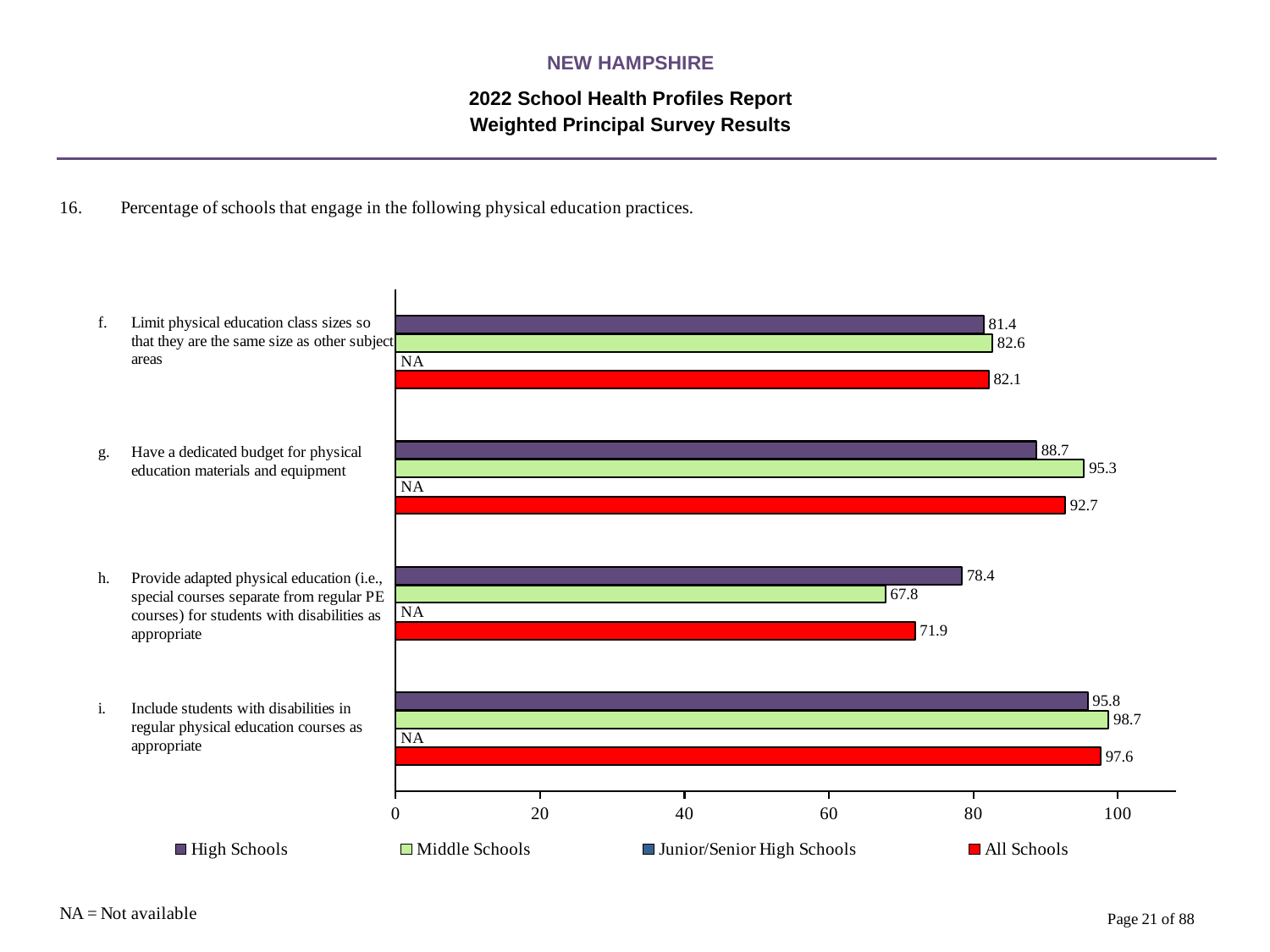
What is the High Schools value for practice g, having a dedicated budget for physical education materials and equipment? 88.7 How many series does the legend list? 4 What is the difference between the Middle Schools and High Schools values for practice g, having a dedicated budget for physical education materials and equipment? 6.6 Which practice has the highest Middle Schools value? i. Include students with disabilities in regular physical education courses as appropriate What is the Middle Schools value for practice h, providing adapted physical education for students with disabilities? 67.8 Which practice has the lowest All Schools value? h. Provide adapted physical education (i.e., special courses separate from regular PE courses) for students with disabilities as appropriate How many physical education practices are shown on the chart? 4 Is the All Schools value for practice f, limiting physical education class sizes, greater or less than 80? greater For practice h, providing adapted physical education, which is larger: the High Schools value or the Middle Schools value? High Schools What kind of chart is shown on the slide? Bar chart What is the All Schools value for practice i, including students with disabilities in regular physical education courses? 97.6 What value is shown for Junior/Senior High Schools for practice f, limiting physical education class sizes? NA